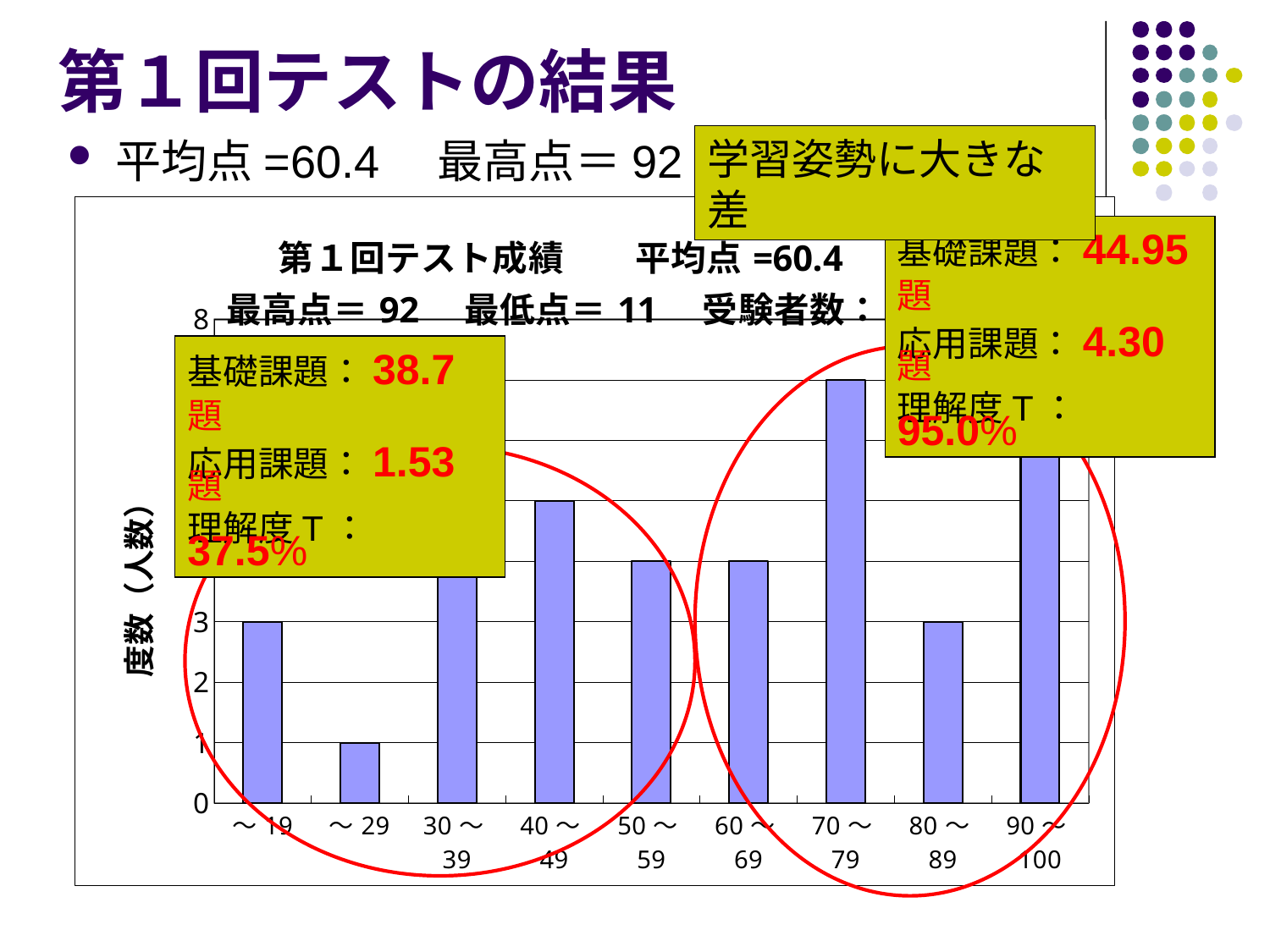
What is the frequency (人数) for the ～29 score range? 1 What is the frequency (人数) for the 70～79 score range? 7 What kind of chart is shown on the slide? bar chart How many score ranges (categories) are shown on the x axis? 9 Which has a higher frequency, the 40～49 range or the 50～59 range? 40～49 What is the frequency (人数) for the ～19 score range? 3 Which score range has the lowest frequency? ～29 What is the frequency (人数) for the 80～89 score range? 3 Which score range has the highest frequency? 70～79 What is the title of the chart? 第１回テスト成績 What is the difference in frequency between the 70～79 range and the ～29 range? 6 What is the label of the vertical axis? 度数（人数）